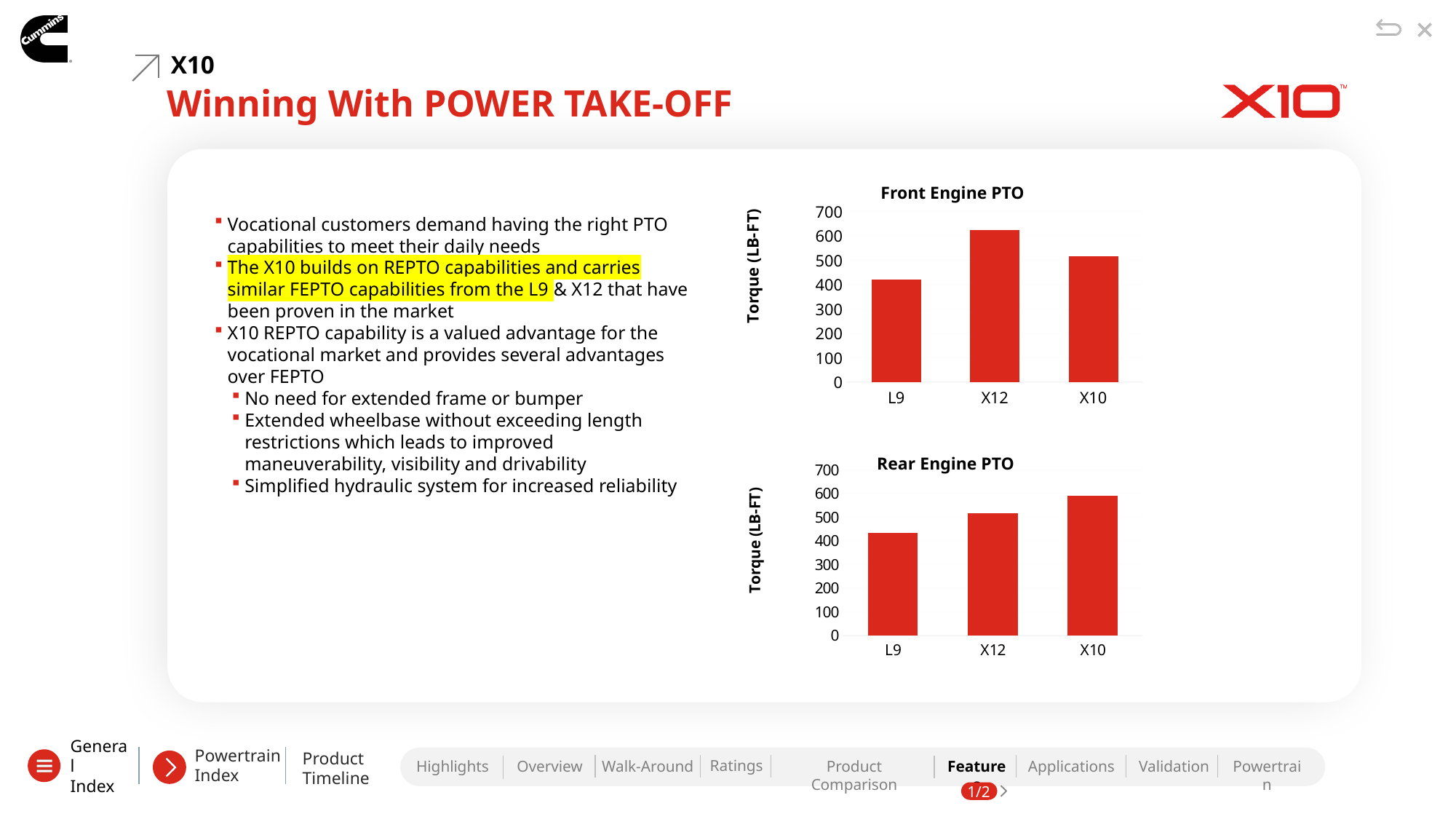
In the Front Engine PTO chart, which has the larger torque, X10 or L9? X10 In the Rear Engine PTO chart, is the value for X10 greater or less than 500? greater What type of chart is the Front Engine PTO chart? Bar chart In the Front Engine PTO chart, which engine has the highest torque? X12 In the Rear Engine PTO chart, which engine has the lowest torque? L9 In the Front Engine PTO chart, which engine has the lowest torque? L9 How many engines are shown in the Rear Engine PTO chart? 3 In the Front Engine PTO chart, is the value for L9 greater or less than 500? less In the Rear Engine PTO chart, is the value for L9 greater or less than 400? greater In the Rear Engine PTO chart, which has the larger torque, X12 or X10? X10 In the Rear Engine PTO chart, which engine has the highest torque? X10